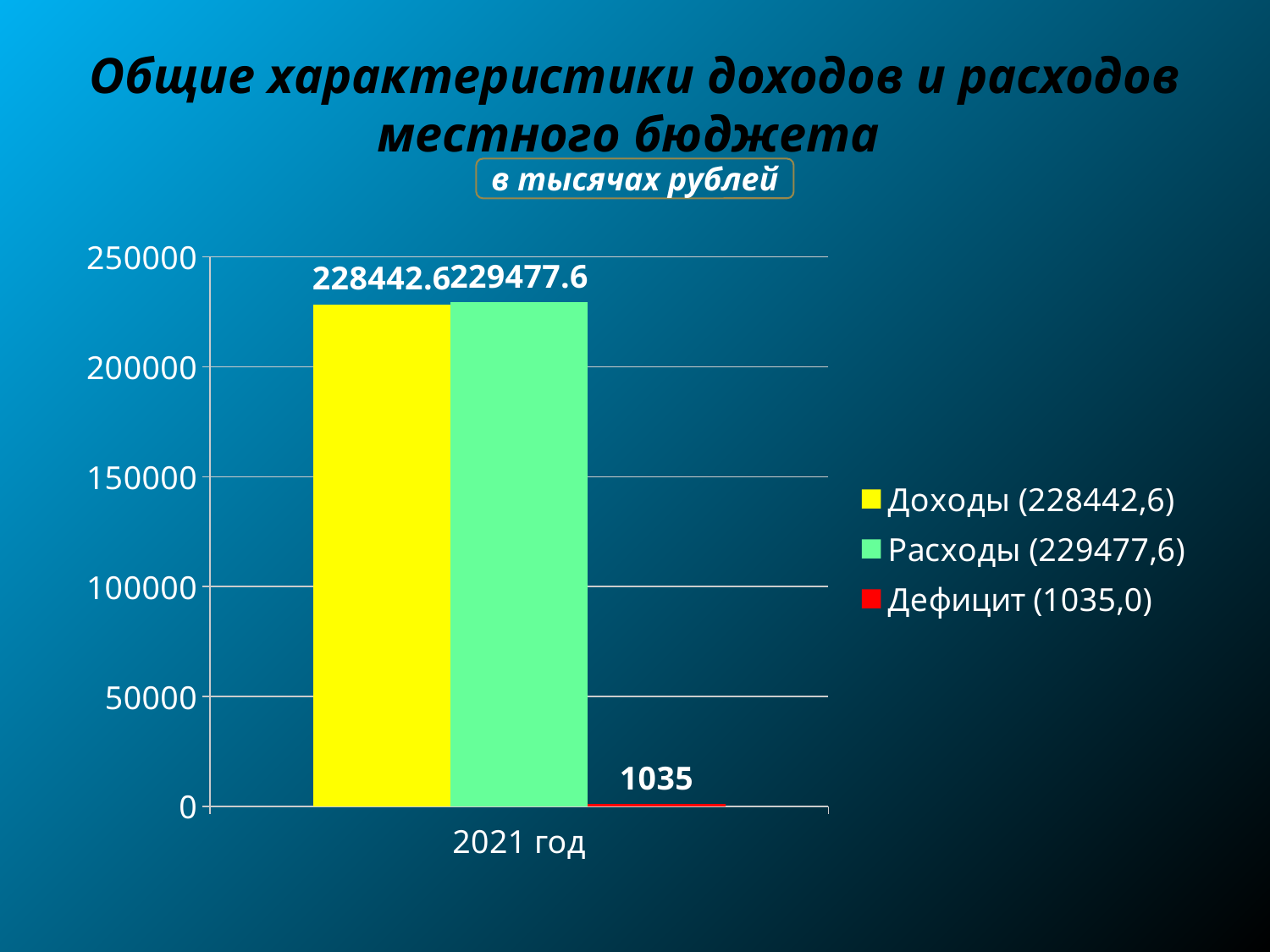
What kind of chart is shown on the slide? bar chart Is the value for Дефицит greater or less than 50000? less Which series has the lowest value in the chart? Дефицит Which is larger, Доходы or Расходы? Расходы How many series does the legend list? 3 What is the value of Дефицит for 2021 год? 1035 What is the value of Доходы for 2021 год? 228442.6 What is the difference between Расходы and Доходы? 1035 Which series has the highest value in the chart? Расходы What colour is the bar for Дефицит? red What is the value of Расходы for 2021 год? 229477.6 Is the value for Доходы greater or less than 200000? greater